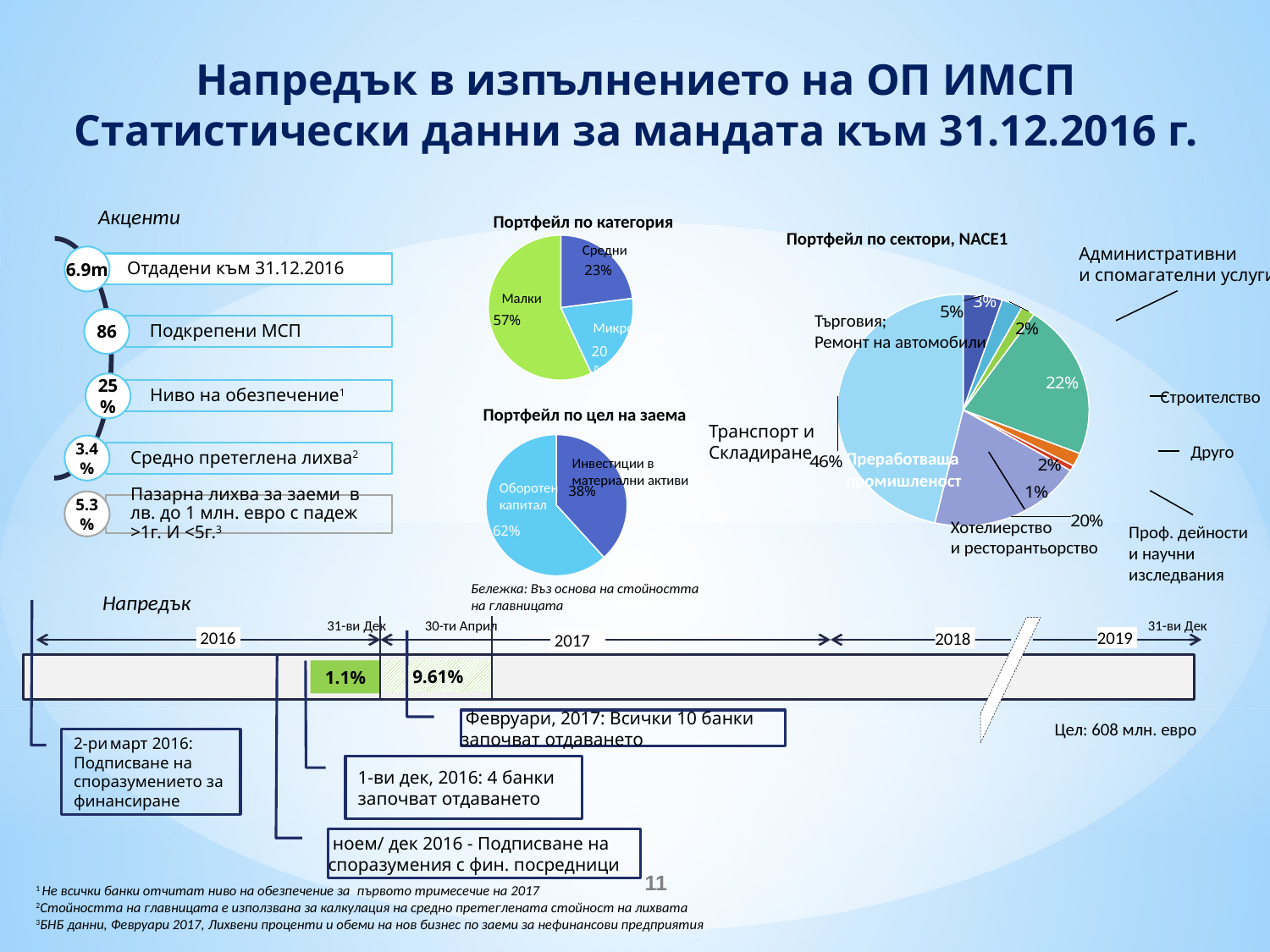
In the 'Портфейл по категория' chart, what share is shown for Микро? 20% In the 'Портфейл по категория' chart, which category has the largest share? Малки In the 'Портфейл по цел на заема' chart, which is larger: Оборотен капитал or Инвестиции в материални активи? Оборотен капитал In the 'Портфейл по категория' chart, how many percentage points larger is Малки than Средни? 34 percentage points In the 'Портфейл по сектори, NACE1' chart, what is the percentage of the largest slice? 46% How many slices does the 'Портфейл по категория' chart have? 3 In the 'Портфейл по категория' chart, what share is shown for Малки? 57% In the 'Портфейл по цел на заема' chart, what share is shown for Инвестиции в материални активи? 38% What type of chart is 'Портфейл по цел на заема'? Pie chart In the 'Портфейл по категория' chart, which category has the smallest share? Микро In the 'Портфейл по цел на заема' chart, what share is shown for Оборотен капитал? 62% In the 'Портфейл по категория' chart, what share is shown for Средни? 23%